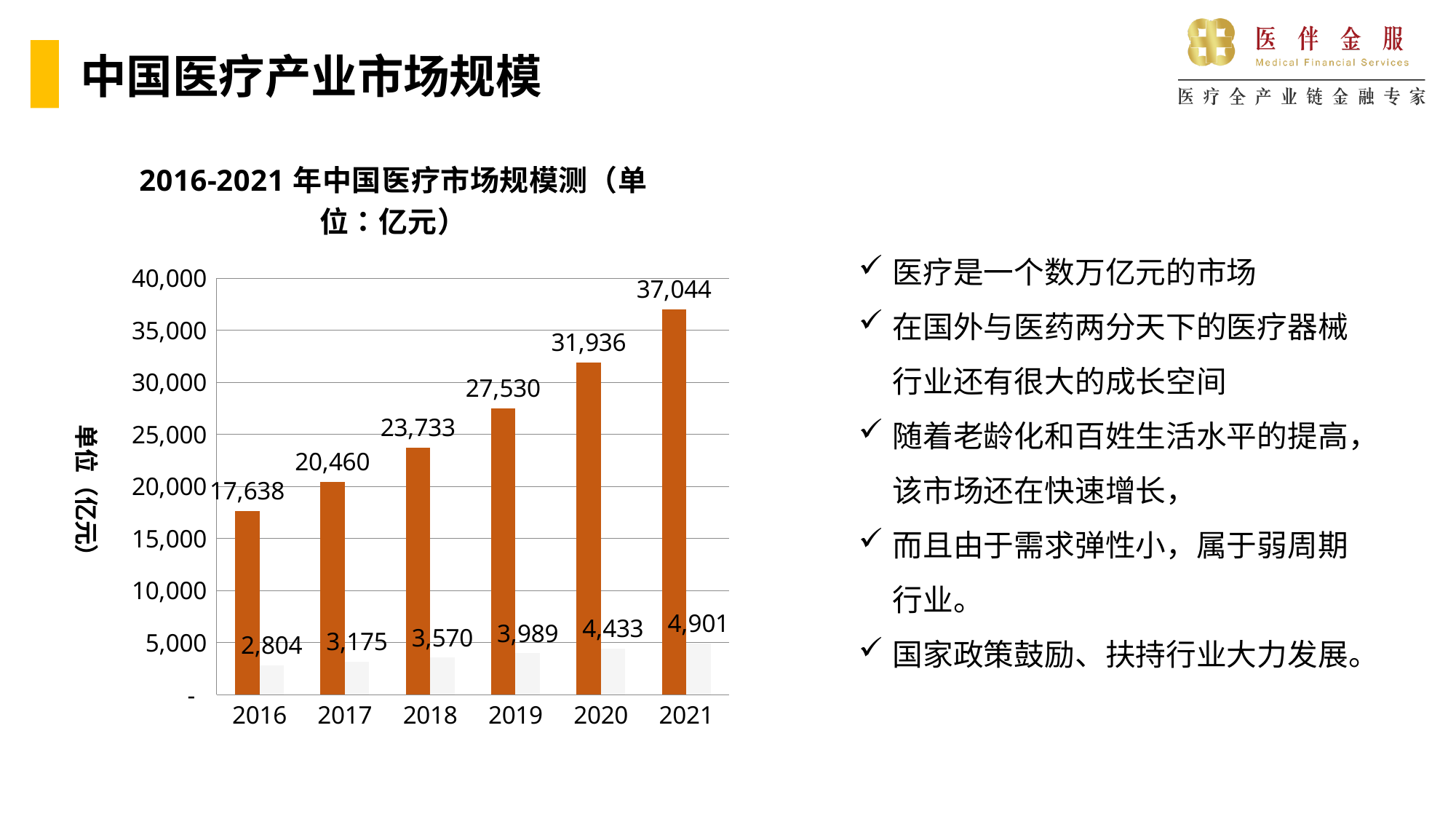
Which is larger, the orange bar for 2019 or the orange bar for 2020? 2020 What is the value of the light grey bar for 2021? 4,901 What is the value of the orange bar for 2016? 17,638 What is the difference between the light grey bar values for 2021 and 2016? 2,097 Which year has the lowest light grey bar? 2016 What is the difference between the orange bar values for 2021 and 2016? 19,406 What is the value of the light grey bar for 2019? 3,989 What is the value of the orange bar for 2021? 37,044 Is the orange bar value for 2018 greater or less than 25,000? less Do the orange bar values rise or fall from 2016 to 2021? rise How many years are shown on the x axis? 6 Which year has the highest orange bar? 2021